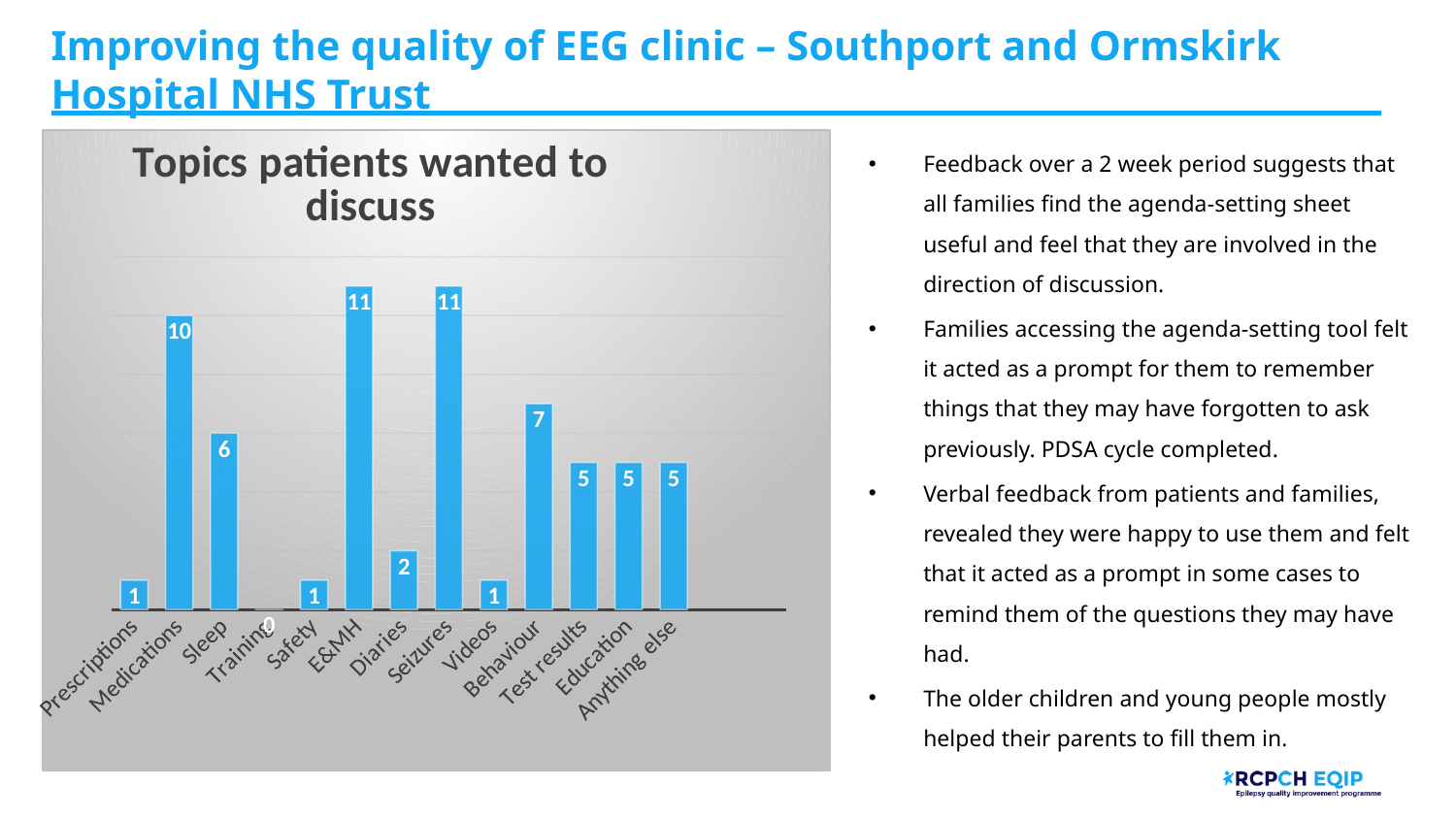
Which is larger, the value for Behaviour or the value for Test results? Behaviour What type of chart is shown on the slide? bar chart What is the value for Behaviour? 7 What is the title of the chart? Topics patients wanted to discuss What is the value for Sleep? 6 What is the difference between the values for Medications and Sleep? 4 What is the value for Medications? 10 What is the value for Diaries? 2 Which two categories share the highest value? E&MH and Seizures Which category has the lowest value? Training How many categories are shown on the x axis? 13 What is the difference between the values for Seizures and Videos? 10